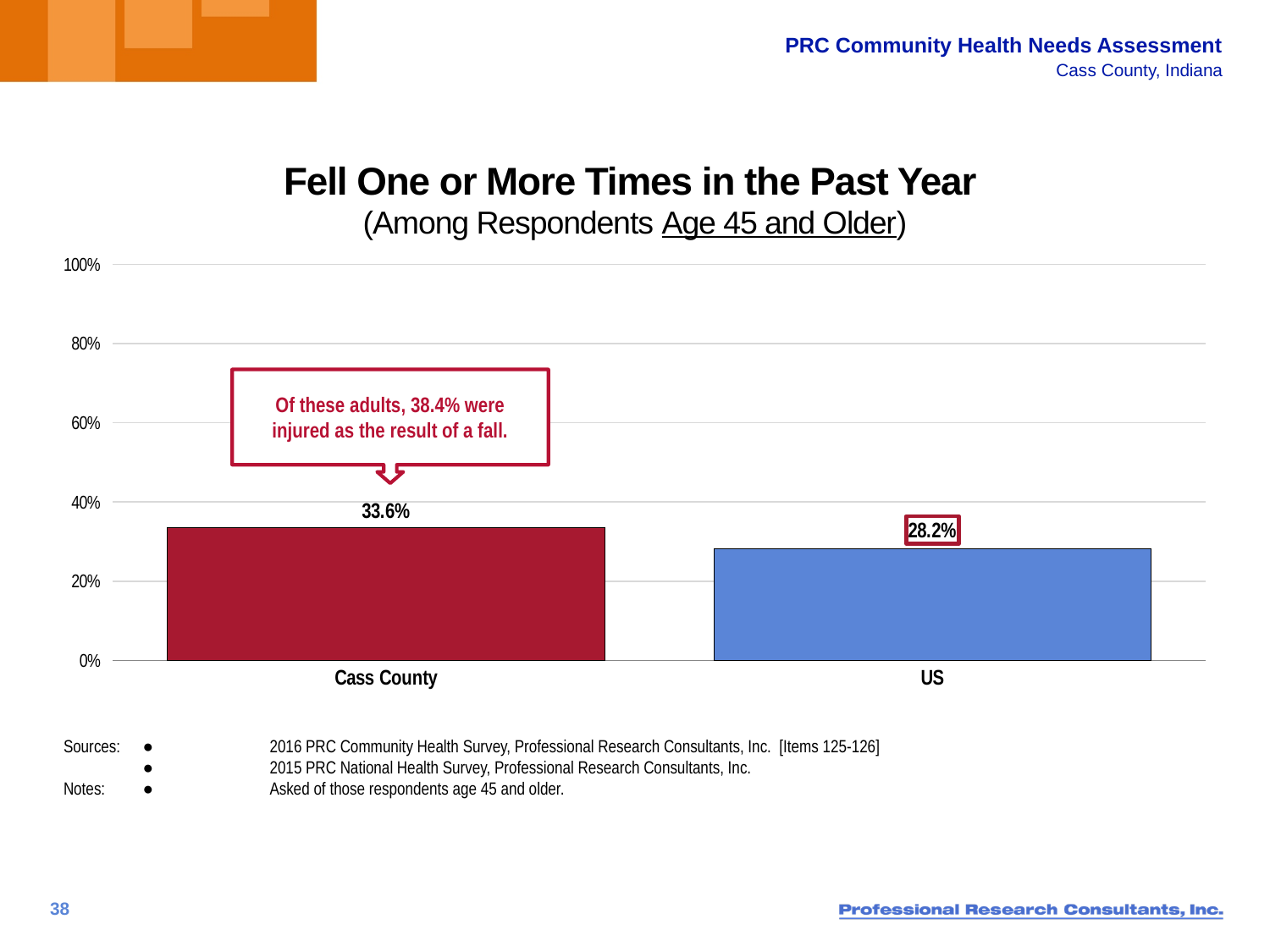
Which category has the lowest value? US What is the title of the chart? Fell One or More Times in the Past Year How many categories are shown on the chart? 2 Which category has the highest value? Cass County What is the difference between the Cass County value and the US value? 5.4% According to the callout on the chart, what percentage of these adults were injured as the result of a fall? 38.4% What is the value for US? 28.2% Which is larger, the value for Cass County or the value for US? Cass County Is the value for US greater or less than 20%? greater What is the value for Cass County? 33.6% Is the value for Cass County greater or less than 40%? less What kind of chart is shown on the slide? bar chart